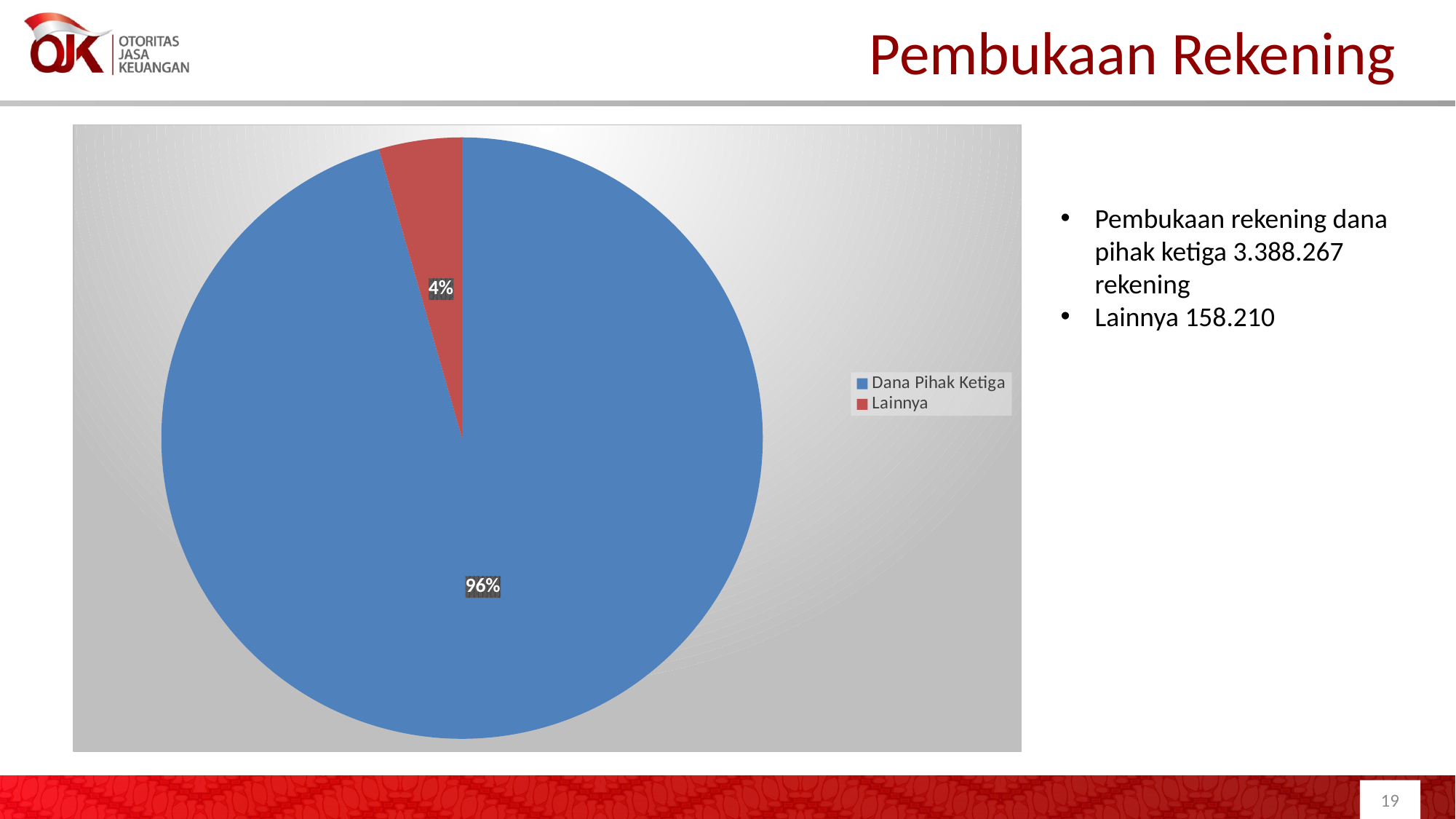
What kind of chart is shown on the slide? pie chart Which category has the largest slice of the pie? Dana Pihak Ketiga What is the difference in percentage points between the Dana Pihak Ketiga slice and the Lainnya slice? 92 How many entries does the legend list? 2 What share of the pie does Lainnya represent? 4% Which is larger, the slice for Dana Pihak Ketiga or the slice for Lainnya? Dana Pihak Ketiga What colour is the slice for Dana Pihak Ketiga? blue What colour is the slice for Lainnya? red What share of the pie does Dana Pihak Ketiga represent? 96% How many slices does the pie chart have? 2 Which category has the smallest slice of the pie? Lainnya